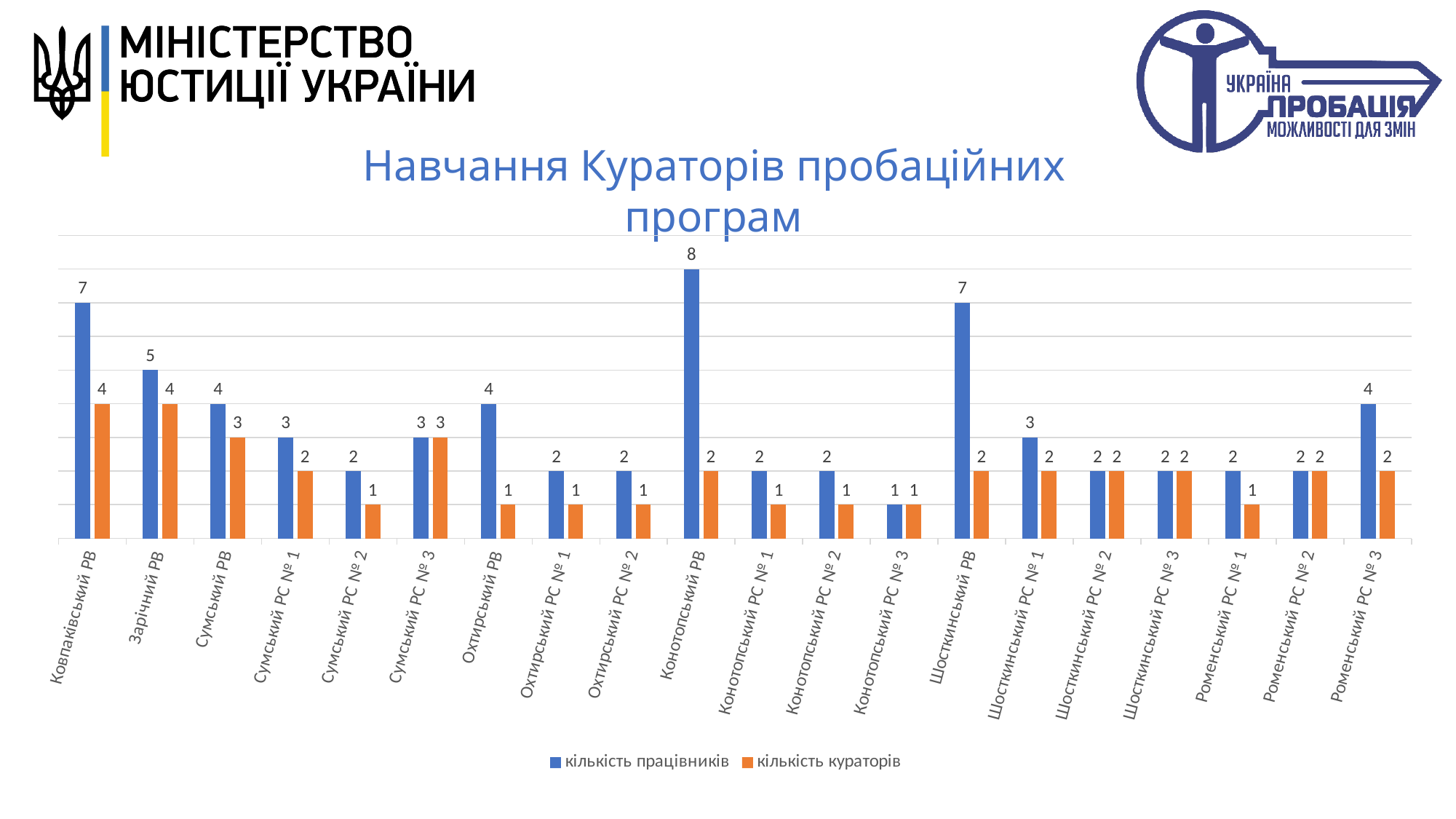
Which category has the highest value for кількість працівників? Конотопський РВ What is the difference between кількість працівників and кількість кураторів for Шосткинський РВ? 5 Which is larger for Ковпаківський РВ: кількість працівників or кількість кураторів? кількість працівників What is the value of кількість працівників for Зарічний РВ? 5 How many categories are shown on the x axis? 20 What type of chart is shown on the slide? bar chart How many series does the legend list? 2 Which category has the lowest value for кількість працівників? Конотопський РС № 3 What is the value of кількість кураторів for Охтирський РВ? 1 What is the title of the chart? Навчання Кураторів пробаційних програм What is the value of кількість працівників for Конотопський РВ? 8 What is the difference in кількість працівників between Конотопський РВ and Ковпаківський РВ? 1